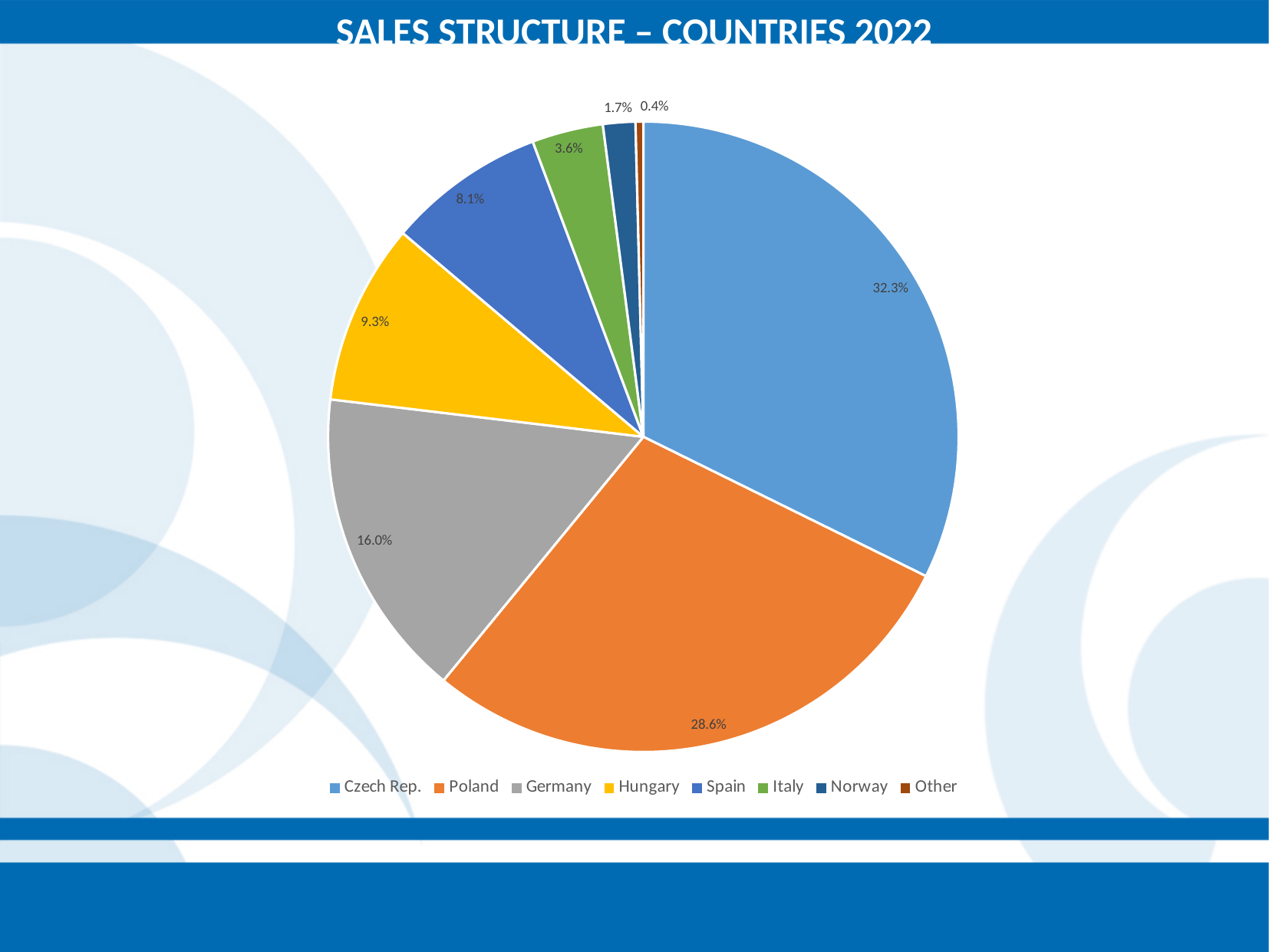
Which category has the smallest share of sales? Other What share of sales does Poland account for? 28.6% What share of sales does Spain account for? 8.1% How many categories does the pie chart show? 8 What is the difference in percentage points between the Czech Rep. and Poland shares? 3.7 What share of sales does Germany account for? 16.0% What share of sales does Czech Rep. account for? 32.3% What is the title of the chart? SALES STRUCTURE – COUNTRIES 2022 What kind of chart is shown on the slide? Pie chart What share of sales does Hungary account for? 9.3% Which country has the largest share of sales? Czech Rep. Which has a larger share of sales, Germany or Hungary? Germany